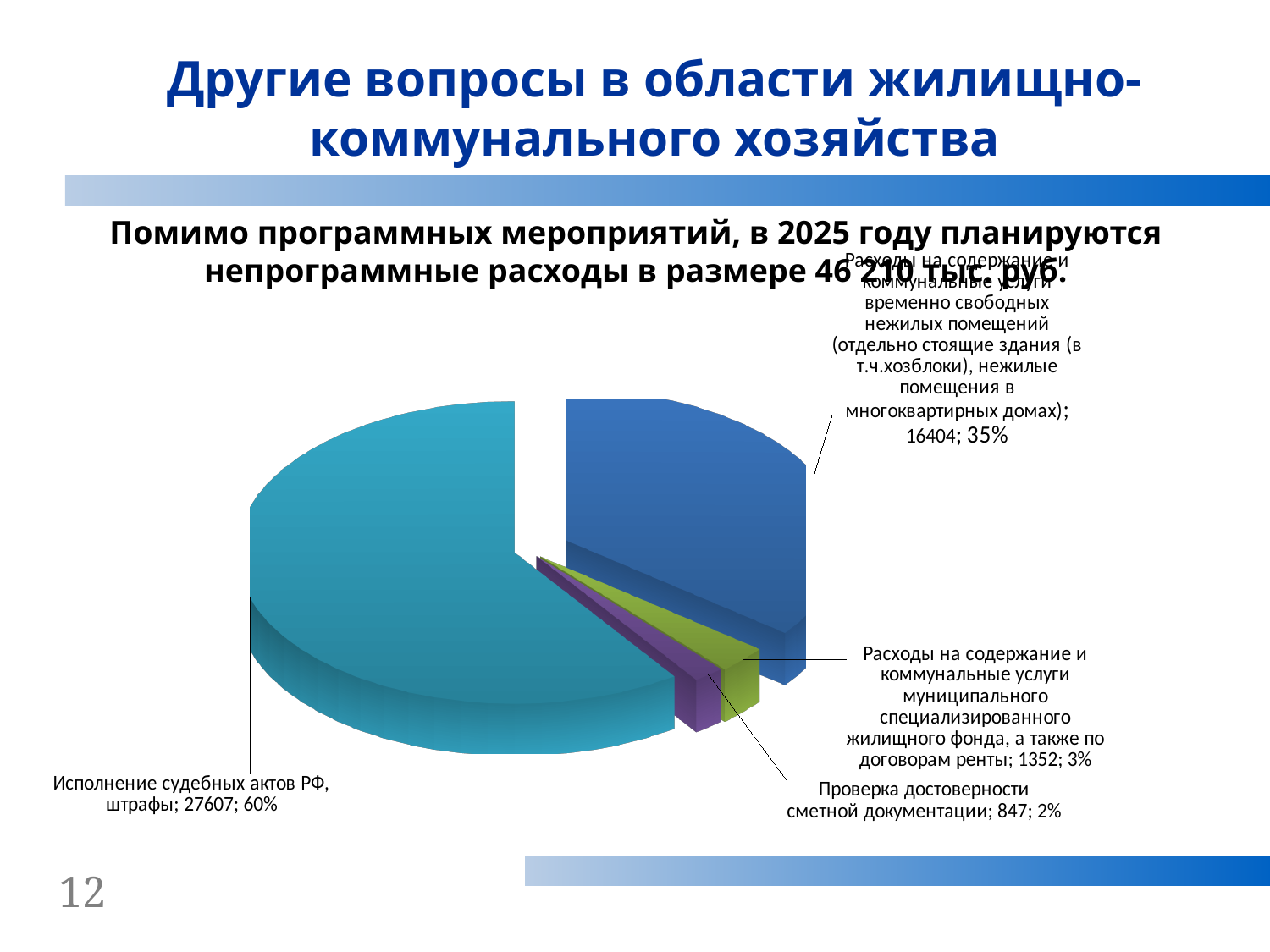
What kind of chart is shown on the slide? Pie chart What is the value for "Проверка достоверности сметной документации"? 847 What is the difference between the value for "Исполнение судебных актов РФ, штрафы" and the value for the slice labelled 16404 (35%)? 11203 What share of the pie does "Исполнение судебных актов РФ, штрафы" represent? 60% What share of the pie does "Проверка достоверности сметной документации" represent? 2% Which is larger: the value for "Проверка достоверности сметной документации" or the value for "Расходы на содержание и коммунальные услуги муниципального специализированного жилищного фонда, а также по договорам ренты"? Расходы на содержание и коммунальные услуги муниципального специализированного жилищного фонда, а также по договорам ренты What colour is the slice for "Исполнение судебных актов РФ, штрафы"? Teal (light blue) What is the value for "Исполнение судебных актов РФ, штрафы"? 27607 How many slices does the pie chart have? 4 What is the value for "Расходы на содержание и коммунальные услуги муниципального специализированного жилищного фонда, а также по договорам ренты"? 1352 Which category has the largest slice of the pie? Исполнение судебных актов РФ, штрафы Which category has the smallest slice of the pie? Проверка достоверности сметной документации